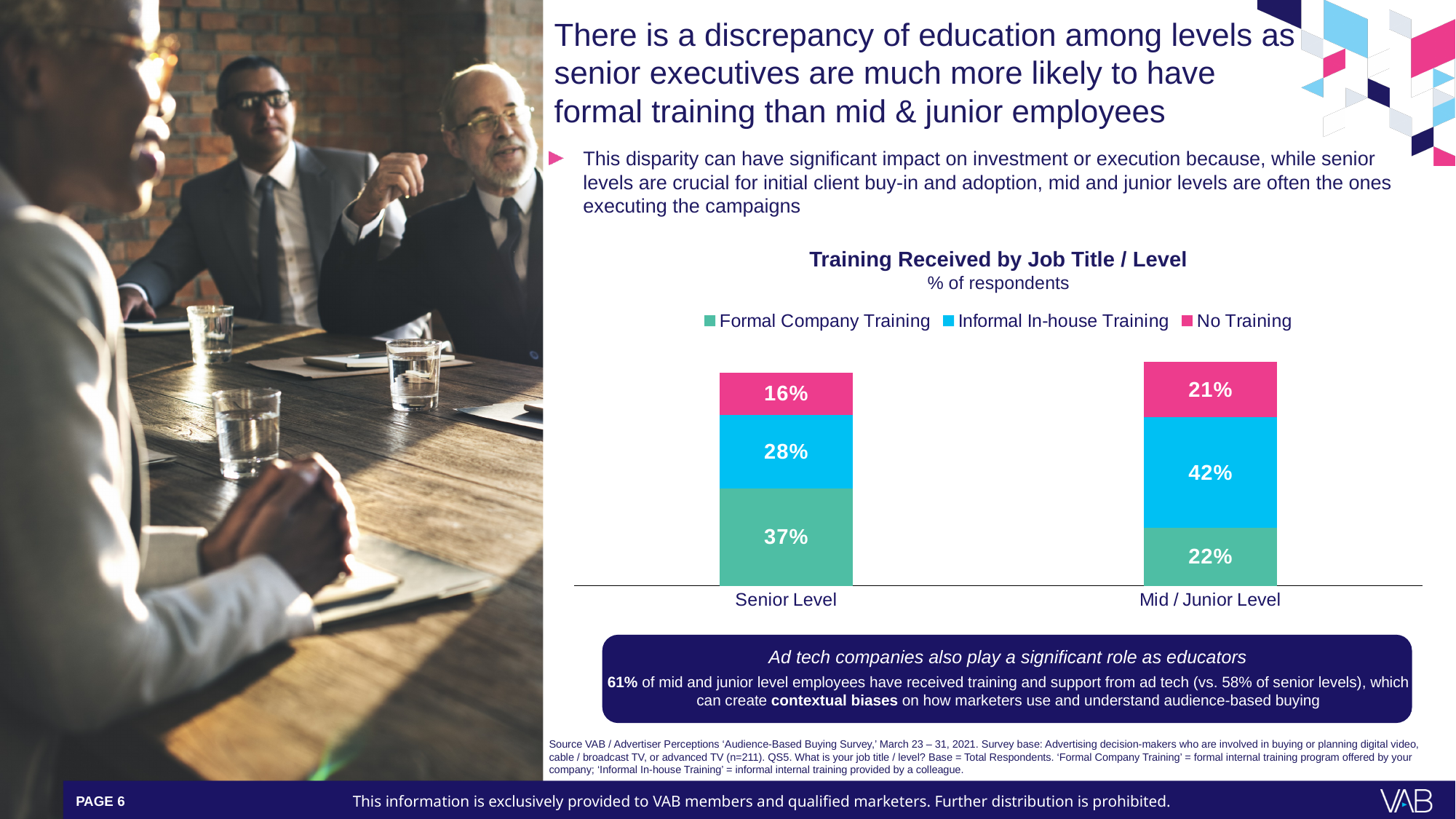
What is the total of the stacked bar for Senior Level? 81% What percentage of Senior Level respondents received Formal Company Training? 37% What is the difference in Formal Company Training between Senior Level and Mid / Junior Level? 15% Which job level has the higher share of Formal Company Training? Senior Level What percentage of Senior Level respondents received Informal In-house Training? 28% What percentage of Mid / Junior Level respondents had No Training? 21% How many job level categories are shown on the x axis? 2 What is the difference in No Training between Mid / Junior Level and Senior Level? 5% What percentage of Mid / Junior Level respondents received Informal In-house Training? 42% How many series does the legend list? 3 What is the total of the stacked bar for Mid / Junior Level? 85% What type of chart is shown? Stacked bar chart